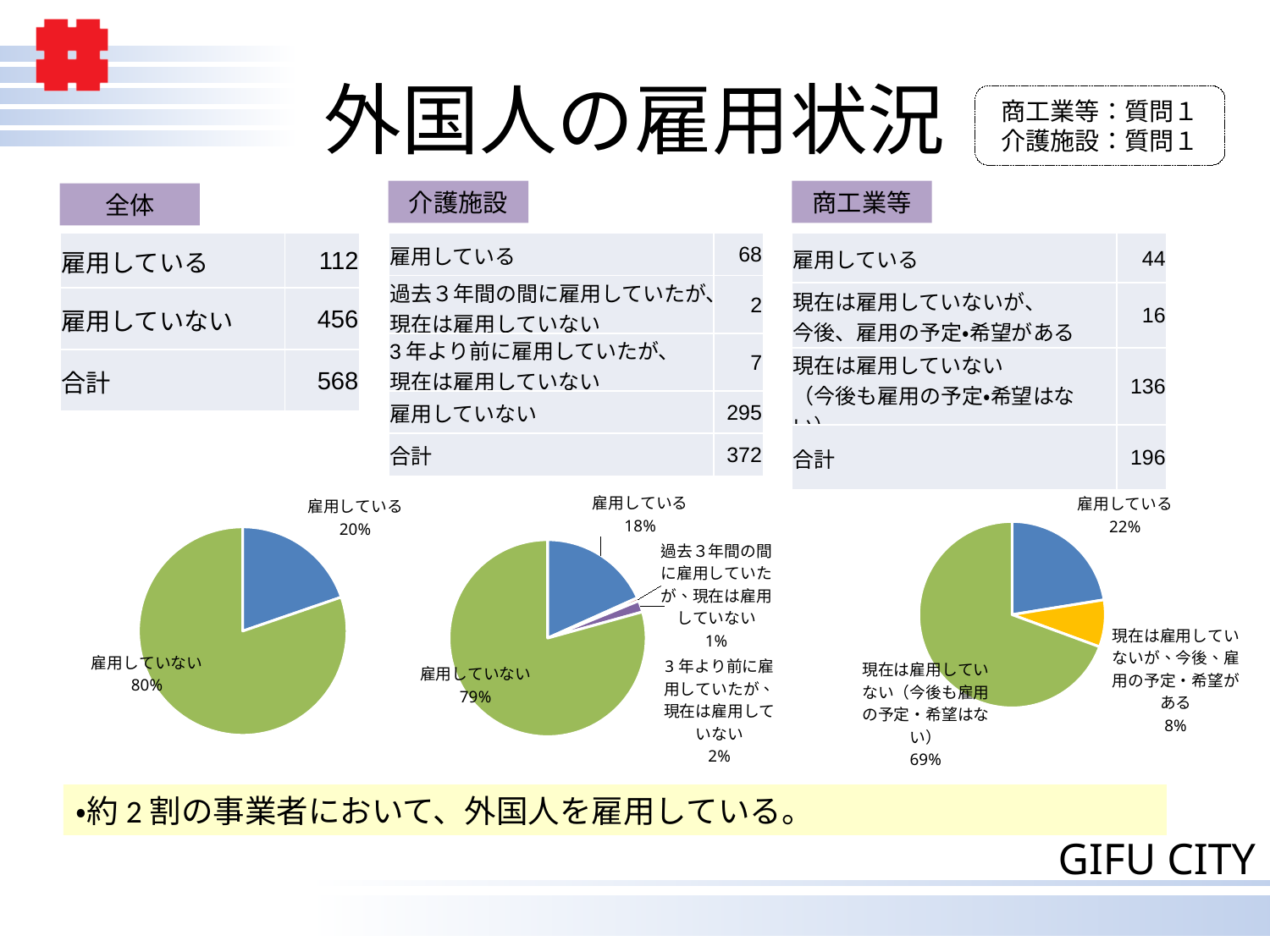
In the right pie chart (商工業等), what share is labelled for 雇用している? 22% In the middle pie chart (介護施設), what share is labelled for 雇用している? 18% How many slices does the middle pie chart (介護施設) have? 4 What kind of chart is used for the three charts on the slide? Pie chart In the left pie chart (全体), which slice is the largest? 雇用していない In the right pie chart (商工業等), what is the difference in percentage points between 雇用している and 現在は雇用していないが、今後、雇用の予定・希望がある? 14 percentage points In the right pie chart (商工業等), what share is labelled for 現在は雇用していないが、今後、雇用の予定・希望がある? 8% In the middle pie chart (介護施設), which slice is the smallest? 過去3年間の間に雇用していたが、現在は雇用していない